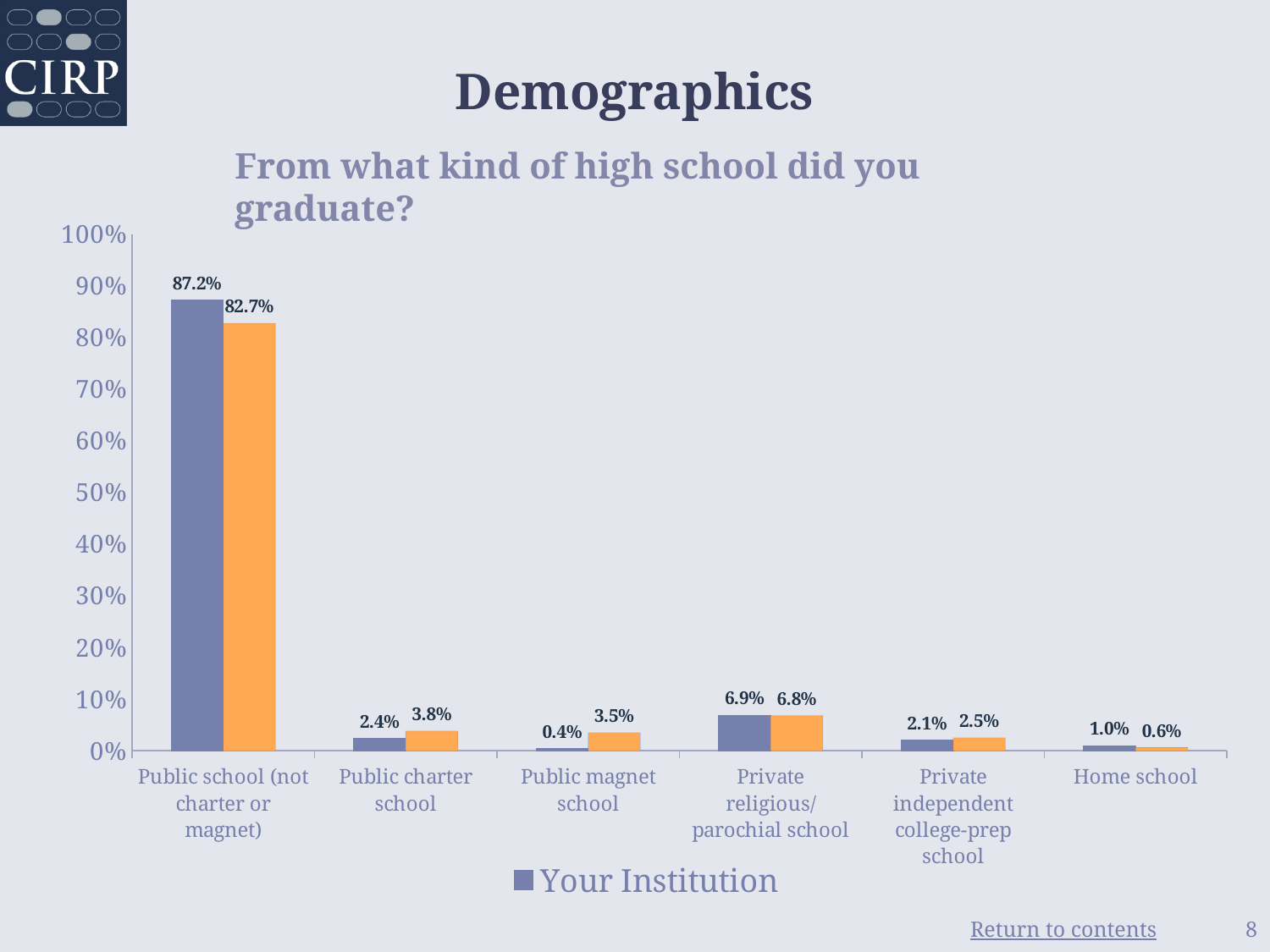
What is the Your Institution value for Private religious/parochial school? 6.9% What is the value for Your Institution for Public school (not charter or magnet)? 87.2% For Public school (not charter or magnet), what is the difference between the Your Institution value and the orange bar's value? 4.5% Which high school type has the lowest value for Your Institution? Public magnet school What kind of chart is shown on the slide? Bar chart For Public magnet school, which is larger: the Your Institution bar or the orange bar? The orange bar For Home school, what is the difference between the Your Institution value and the orange bar's value? 0.4% Which high school type has the highest value for Your Institution? Public school (not charter or magnet) What value does the orange bar show for Public charter school? 3.8% How many high school types are shown on the x axis? 6 Is the Your Institution value for Public school (not charter or magnet) greater or less than 80%? greater What is the Your Institution value for Home school? 1.0%